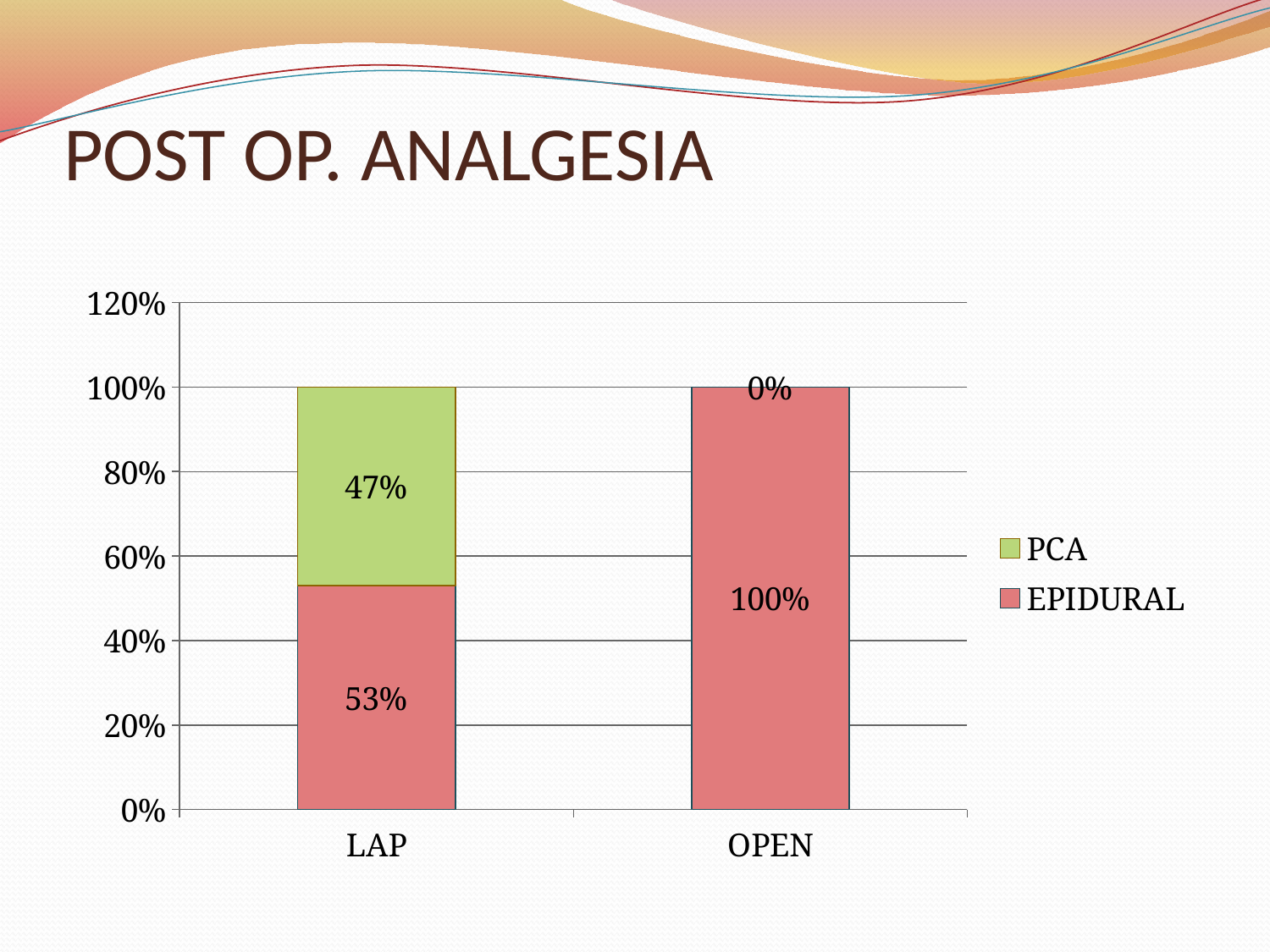
What is the EPIDURAL value for LAP? 53% What kind of chart is shown on the slide? Stacked bar chart What is the total of the stacked bar for LAP? 100% How many categories are shown on the x axis? 2 Which category has the higher EPIDURAL value, LAP or OPEN? OPEN What is the EPIDURAL value for OPEN? 100% What is the PCA value for LAP? 47% What is the PCA value for OPEN? 0% What is the difference between the EPIDURAL values for OPEN and LAP? 47% What is the difference between the EPIDURAL and PCA values for LAP? 6% Which category has the highest PCA value? LAP How many series does the legend list? 2